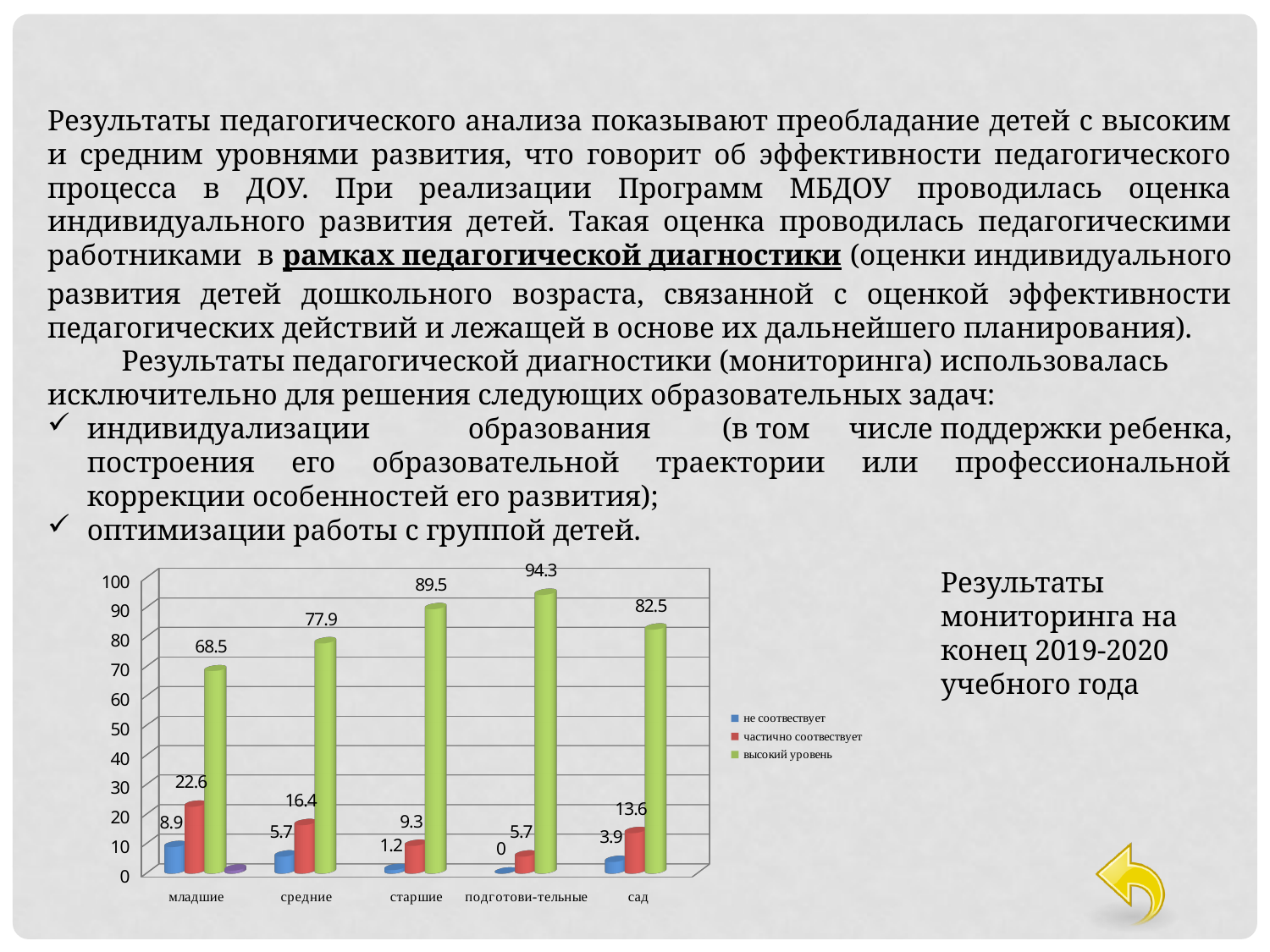
How many series does the chart legend list? 3 Which is larger: 'частично соответствует' for 'средние' or for 'сад'? средние What is the value of 'высокий уровень' for 'подготови-тельные'? 94.3 Does the value of 'высокий уровень' for 'средние' rise or fall compared with 'младшие'? rise What is the title text shown to the right of the chart? Результаты мониторинга на конец 2019-2020 учебного года Which category has the highest value for 'высокий уровень'? подготови-тельные What is the value of 'не соответствует' for 'сад'? 3.9 How many categories are shown on the x axis of the chart? 5 What type of chart is shown on the slide? bar chart Which category has the lowest value for 'не соответствует'? подготови-тельные What is the difference between the 'высокий уровень' values for 'старшие' and 'младшие'? 21 What is the value of 'частично соответствует' for 'младшие'? 22.6